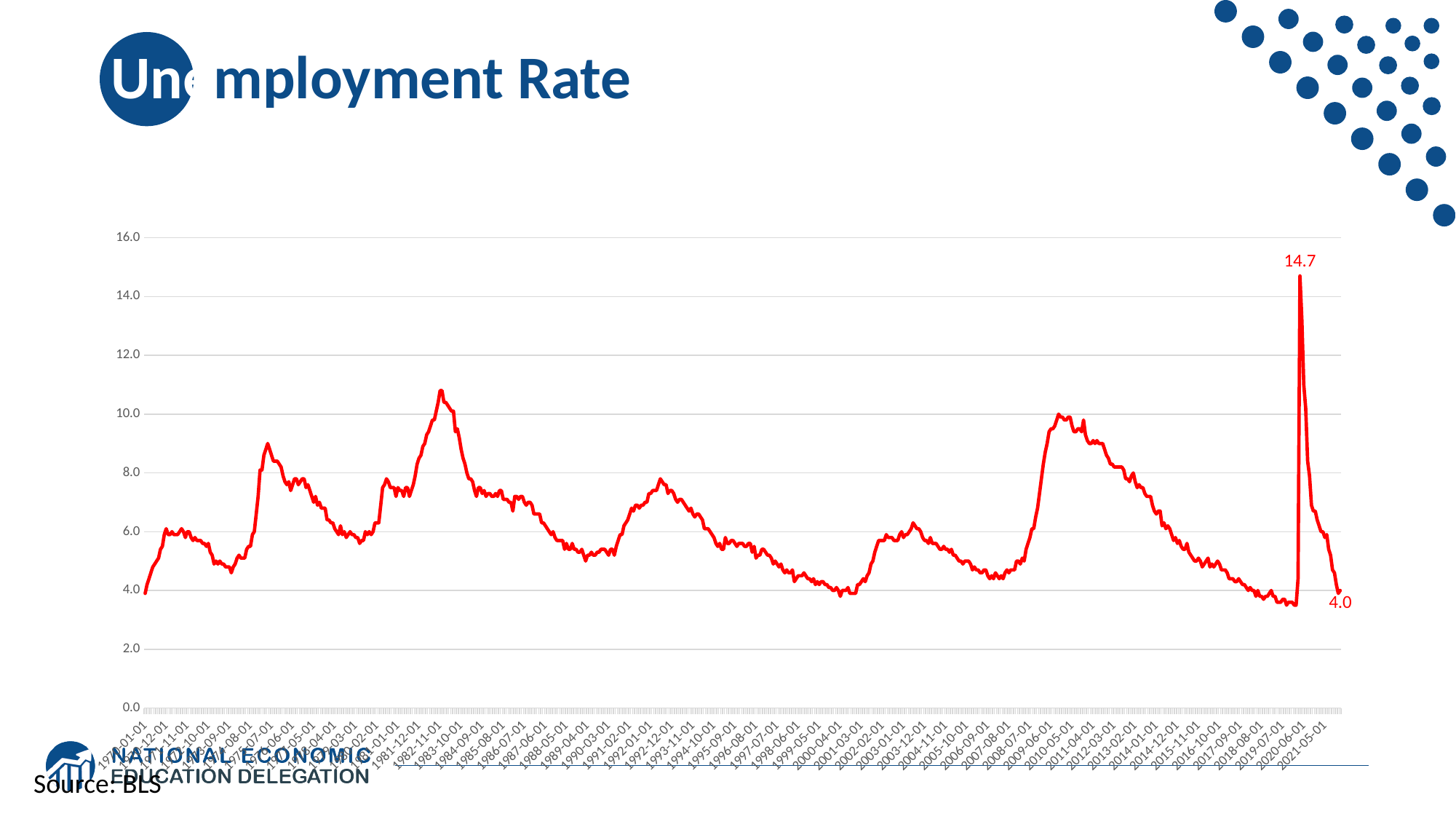
Is the unemployment rate at its peak around 2009-2010 greater or less than 8.0? greater What is the title of the chart on the slide? Unemployment Rate Is the unemployment rate around 2000 greater or less than 6.0? less Between 2010 and 2019, does the unemployment rate generally rise or fall? fall Is the labelled peak value in 2020 greater or less than 14.0? greater Which peak is higher: the one around 1982-1983 or the one around 1992? the one around 1982-1983 What is the value labelled at the end of the line, in 2021? 4.0 What is the highest unemployment rate value labelled on the chart? 14.7 What kind of chart is shown on the slide? line chart What is the difference between the labelled peak value of 14.7 and the final labelled value of 4.0? 10.7 What is the highest value shown on the vertical axis? 16.0